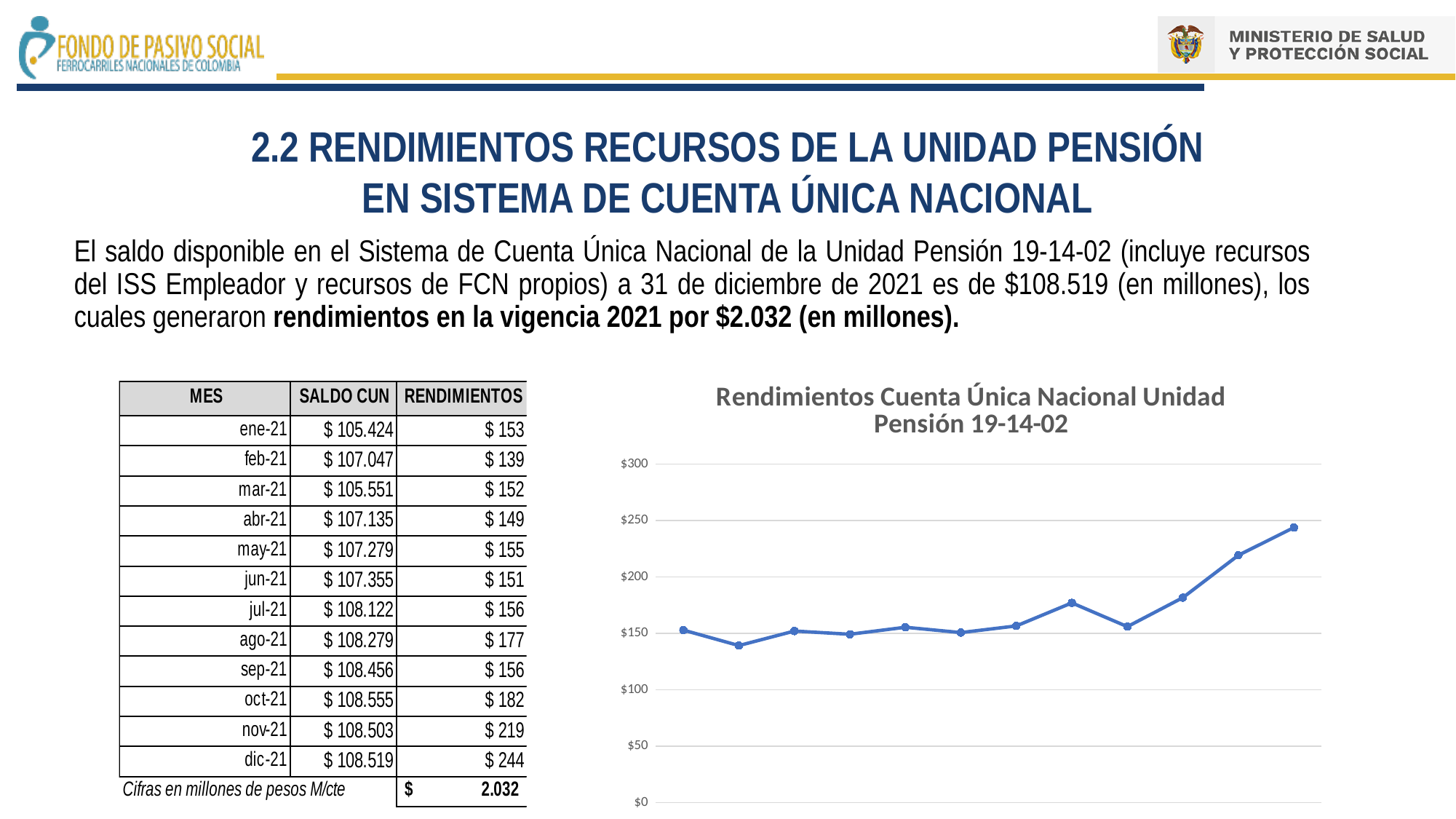
According to the slide, what is the rendimientos value for dic-21, the highest point on the chart? $ 244 Which point on the line chart has the highest value, the first or the last? the last Is the value of the last point on the line chart greater or less than $250? less Is the value of the second point on the line chart greater or less than $150? less What kind of chart is shown on the slide? line chart Is the value of the last (rightmost) point on the line chart greater or less than $200? greater According to the slide, what is the rendimientos value for feb-21, the lowest point on the chart? $ 139 What is the highest value shown on the chart's vertical axis? $300 What is the title of the chart? Rendimientos Cuenta Única Nacional Unidad Pensión 19-14-02 Overall, do the values on the line chart rise or fall from left to right? rise How many data points are plotted on the line chart? 12